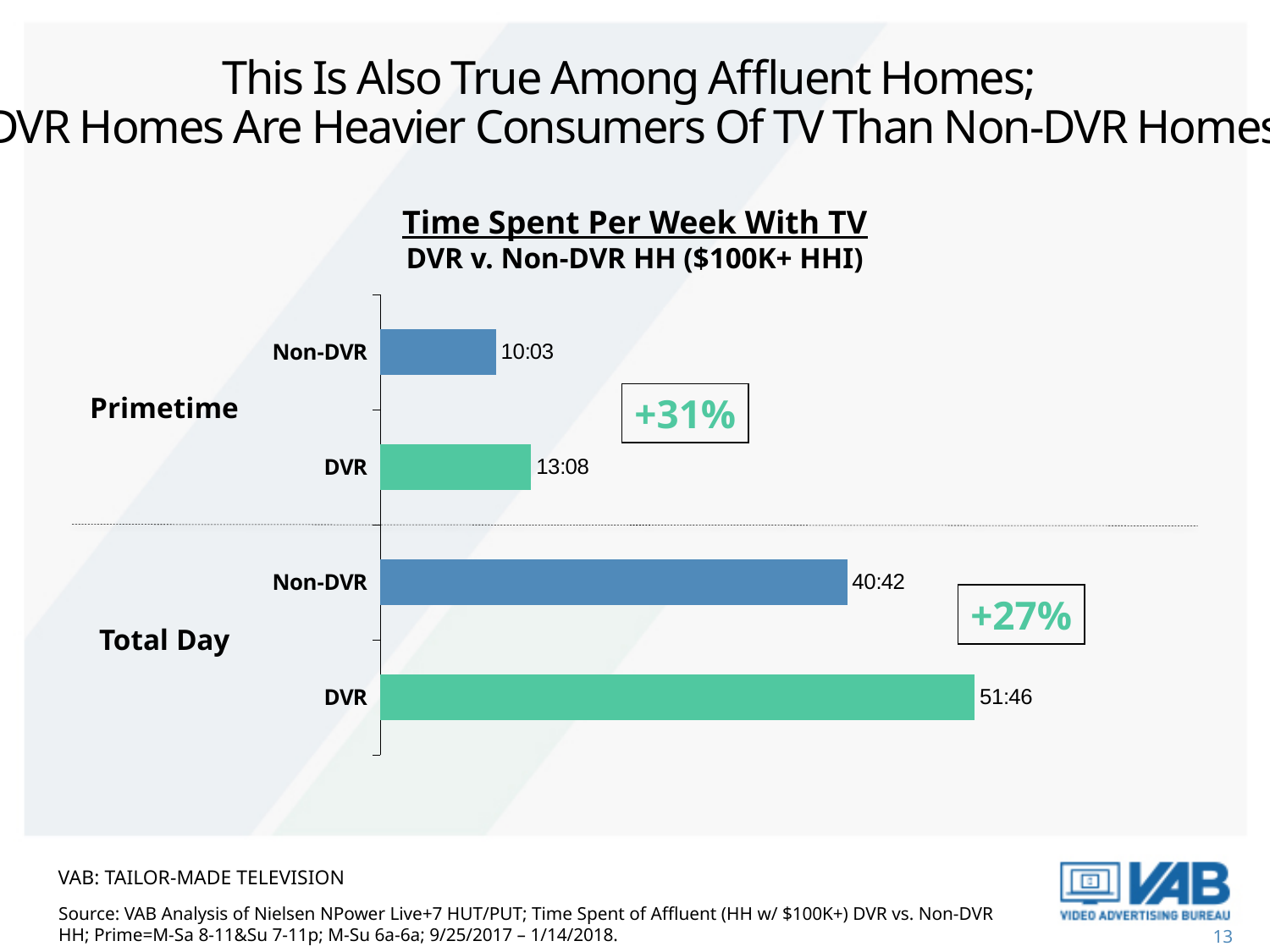
In Total Day, which group spends more time with TV, DVR or Non-DVR households? DVR How many bars are plotted in the chart? 4 What is the time spent per week with TV for Non-DVR households in Primetime? 10:03 Which bar shows the lowest time spent per week with TV? Primetime Non-DVR (10:03) What is the difference in Primetime time spent between DVR and Non-DVR households? 3:05 What is the time spent per week with TV for Non-DVR households for Total Day? 40:42 What is the difference in Total Day time spent between DVR and Non-DVR households? 11:04 What type of chart is shown on the slide? Bar chart Which bar shows the highest time spent per week with TV? Total Day DVR (51:46) What is the time spent per week with TV for DVR households for Total Day? 51:46 What is the time spent per week with TV for DVR households in Primetime? 13:08 What percentage increase is annotated for DVR over Non-DVR households in Primetime? +31%